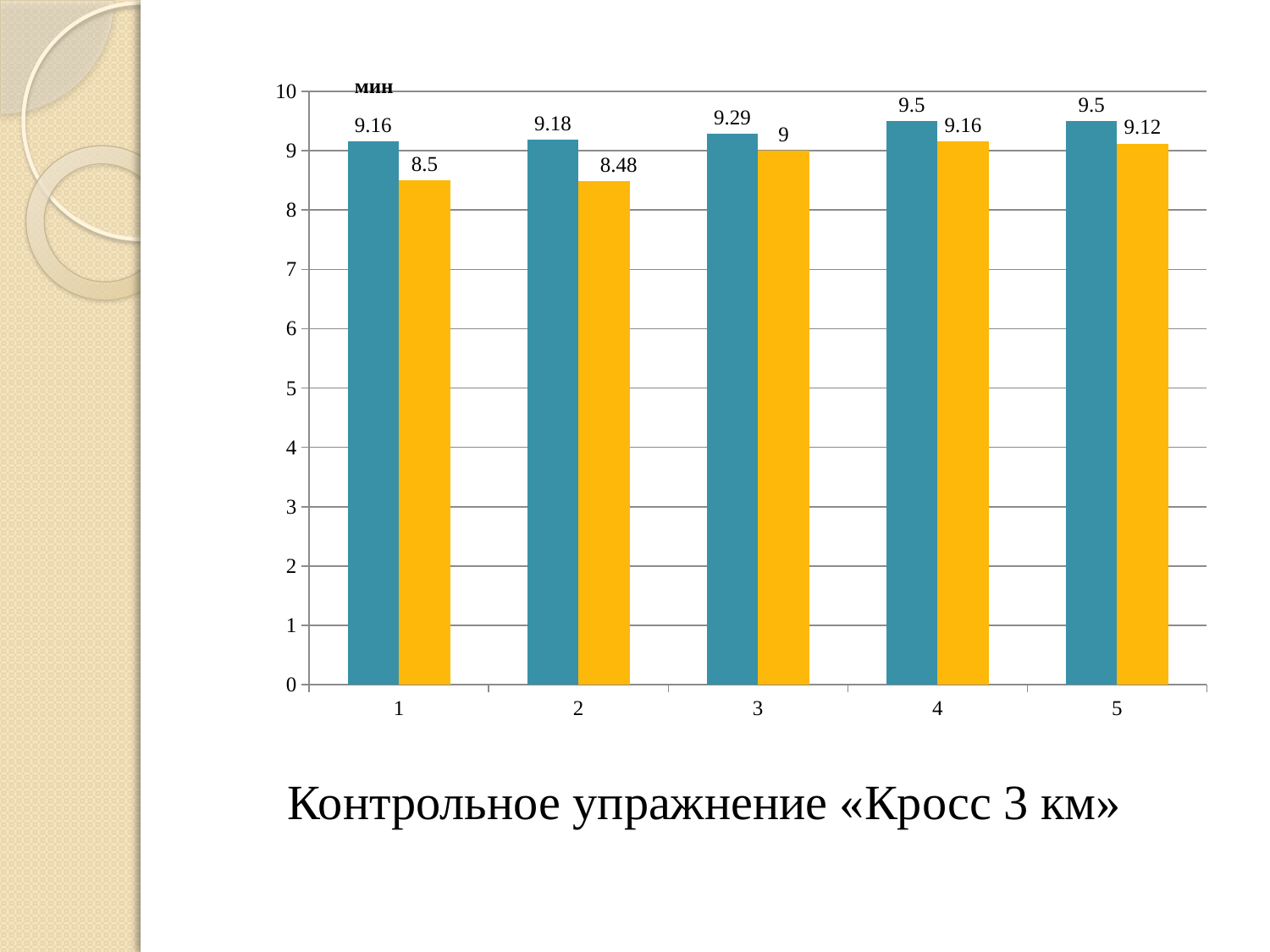
What kind of chart is shown on the slide? bar chart What is the value of the blue bar for category 1? 9.16 What unit is written at the top of the vertical axis? мин Which is larger for category 3: the blue bar or the orange bar? the blue bar What is the value of the orange bar for category 3? 9 What is the difference between the blue and orange bars for category 5? 0.38 What is the value of the orange bar for category 2? 8.48 How many categories are shown on the x axis? 5 For which category is the orange bar the highest? 4 What is the difference between the blue and orange bars for category 1? 0.66 For which category is the orange bar the lowest? 2 What is the value of the blue bar for category 5? 9.5